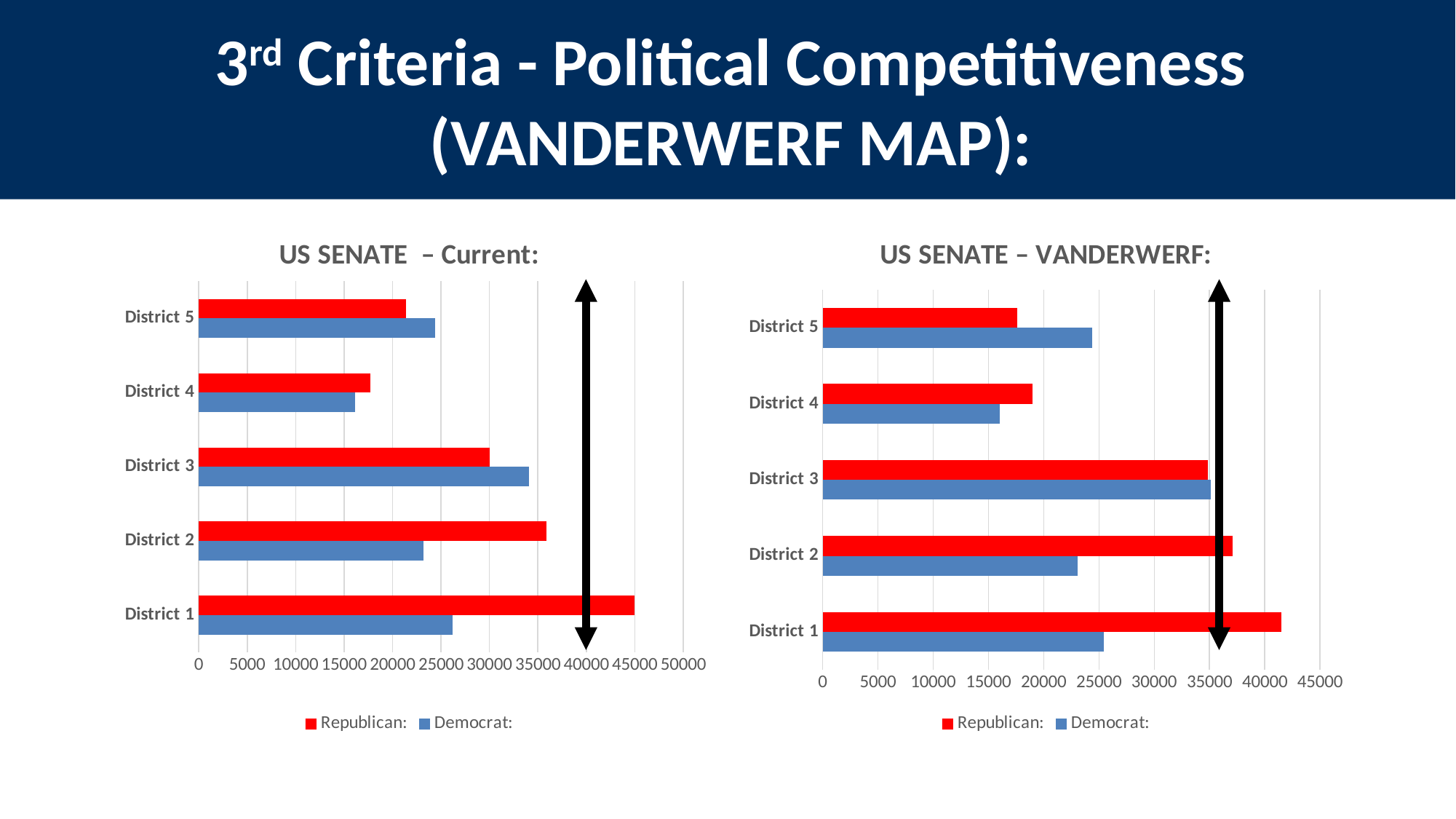
How many districts are shown on the "US SENATE – Current:" chart? 5 In the "US SENATE – Current:" chart, which district has the highest Republican value? District 1 In the "US SENATE – Current:" chart, is the Democrat value for District 2 greater or less than 25000? less In the "US SENATE – VANDERWERF:" chart, which is larger for District 2, the Republican value or the Democrat value? Republican In the "US SENATE – VANDERWERF:" chart, is the Republican value for District 1 greater or less than 40000? greater In the "US SENATE – Current:" chart, which is larger for District 3, the Republican value or the Democrat value? Democrat What kind of chart is the "US SENATE – Current:" chart? bar chart How many series does the legend of the "US SENATE – VANDERWERF:" chart list? 2 In the "US SENATE – Current:" chart, which district has the lowest Democrat value? District 4 What colour represents the Democrat series in the charts? blue In the "US SENATE – VANDERWERF:" chart, is the Democrat value for District 4 greater or less than 20000? less In the "US SENATE – VANDERWERF:" chart, which district has the lowest Republican value? District 5